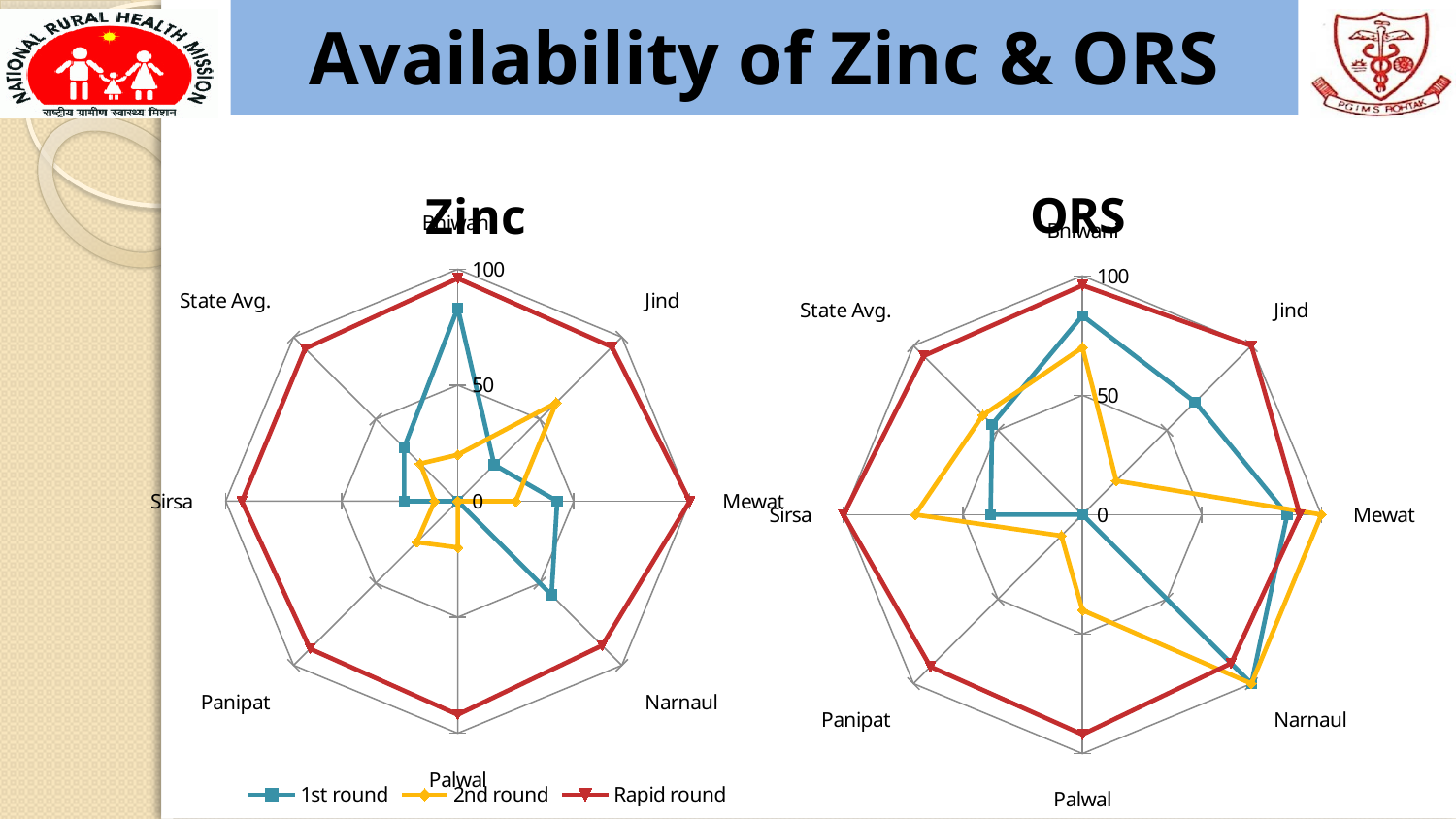
In the Zinc chart, which is larger for Bhiwani: the 1st round value or the 2nd round value? 1st round In the Zinc chart, is the 1st round value for Jind greater or less than 50? less In the ORS chart, is the 1st round value for Mewat greater or less than 50? greater How many series does the legend list? 3 In the Zinc chart, is the 1st round value for Sirsa greater or less than 50? less In the ORS chart, which is larger in the 2nd round: Mewat or Jind? Mewat How many categories (axes) does the ORS radar chart have? 8 What kind of chart is the Zinc chart? Radar chart